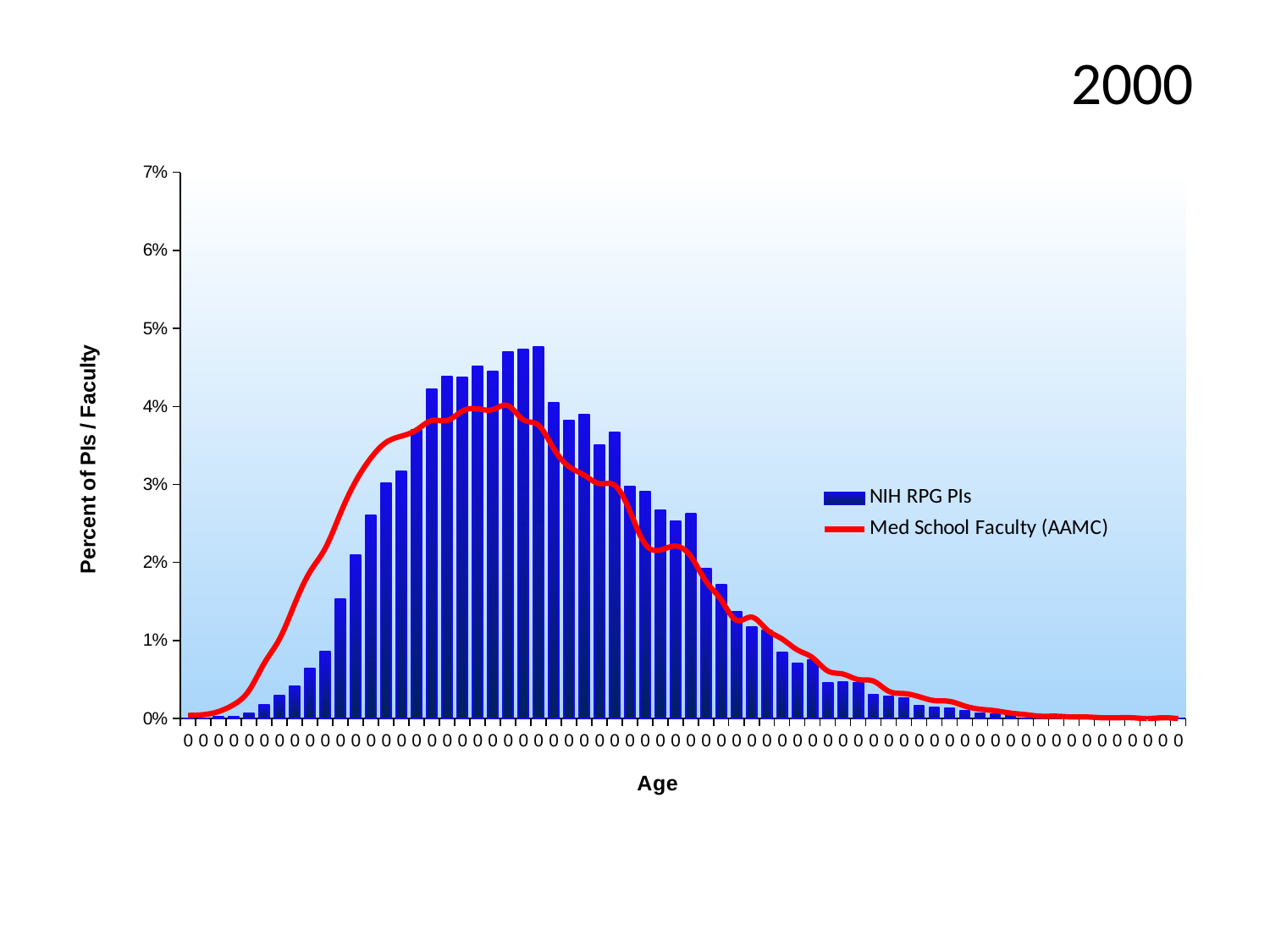
How many series does the legend list? 2 Is the highest value for NIH RPG PIs greater or less than 4%? greater Is the highest value for NIH RPG PIs greater or less than 5%? less Which series is drawn as bars? NIH RPG PIs What is the title of the x axis? Age Which series reaches a higher peak value, NIH RPG PIs or Med School Faculty (AAMC)? NIH RPG PIs What kind of chart is this? A combined bar and line chart Do the values for NIH RPG PIs rise or fall across the right half of the x axis? fall Do the values for Med School Faculty (AAMC) rise or fall across the left quarter of the x axis? rise Is the peak of the Med School Faculty (AAMC) line greater or less than 5%? less